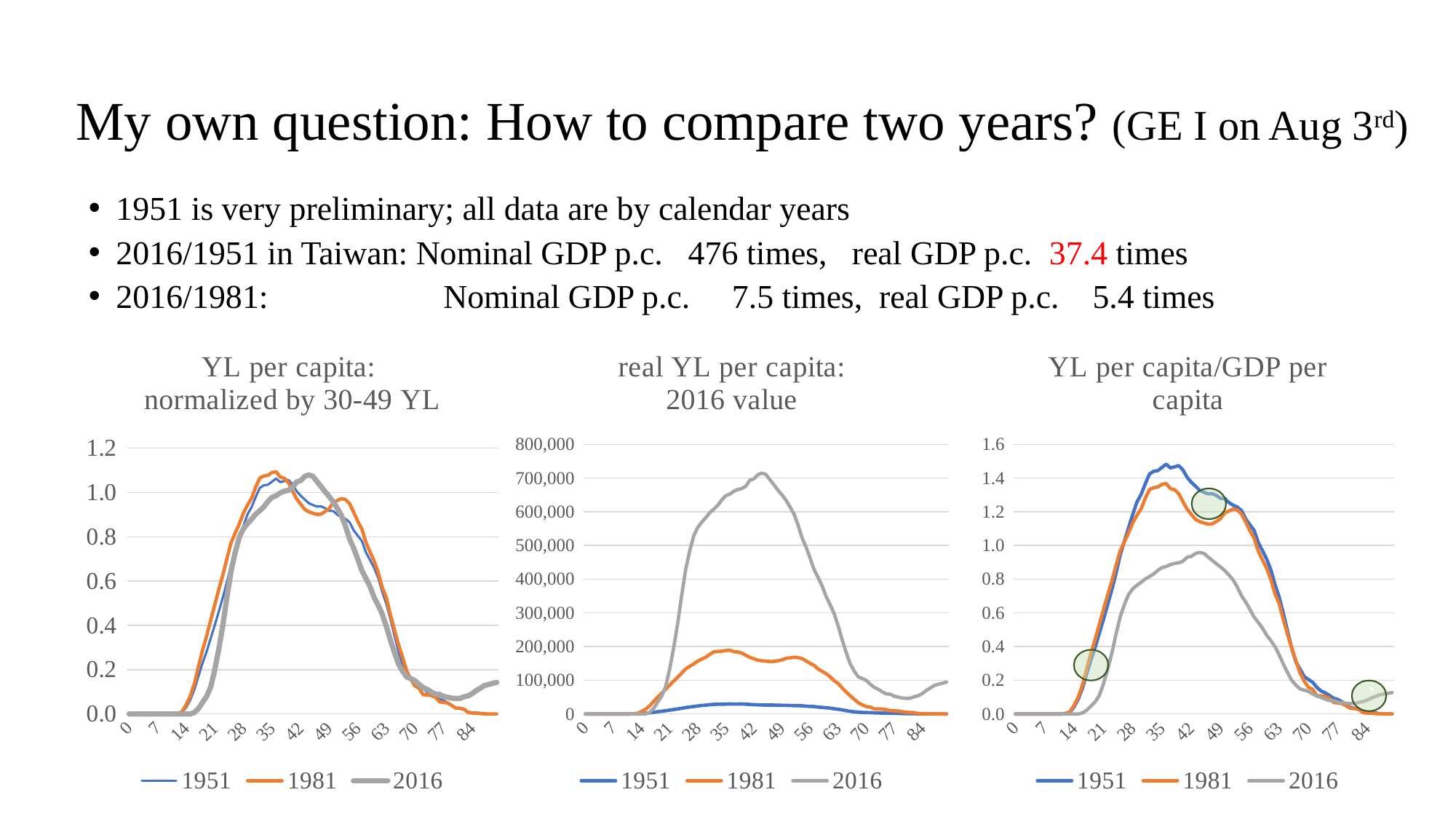
What are the legend entries of the right chart 'YL per capita/GDP per capita'? 1951, 1981, 2016 What kind of chart is the left chart titled 'YL per capita: normalized by 30-49 YL'? line chart In the middle chart 'real YL per capita: 2016 value', is the peak value of the 2016 series greater or less than 600,000? greater In the right chart 'YL per capita/GDP per capita', is the peak value of the 1951 series greater or less than 1.4? greater In the middle chart 'real YL per capita: 2016 value', is the value of the 1951 series at age 42 greater or less than 100,000? less In the middle chart 'real YL per capita: 2016 value', which series has the lowest values across all ages? 1951 In the right chart 'YL per capita/GDP per capita', which series reaches the highest peak? 1951 How many series does the legend of the middle chart 'real YL per capita: 2016 value' list? 3 In the right chart 'YL per capita/GDP per capita', at age 35, which series has the larger value: 1951 or 2016? 1951 In the middle chart 'real YL per capita: 2016 value', which series reaches the highest values? 2016